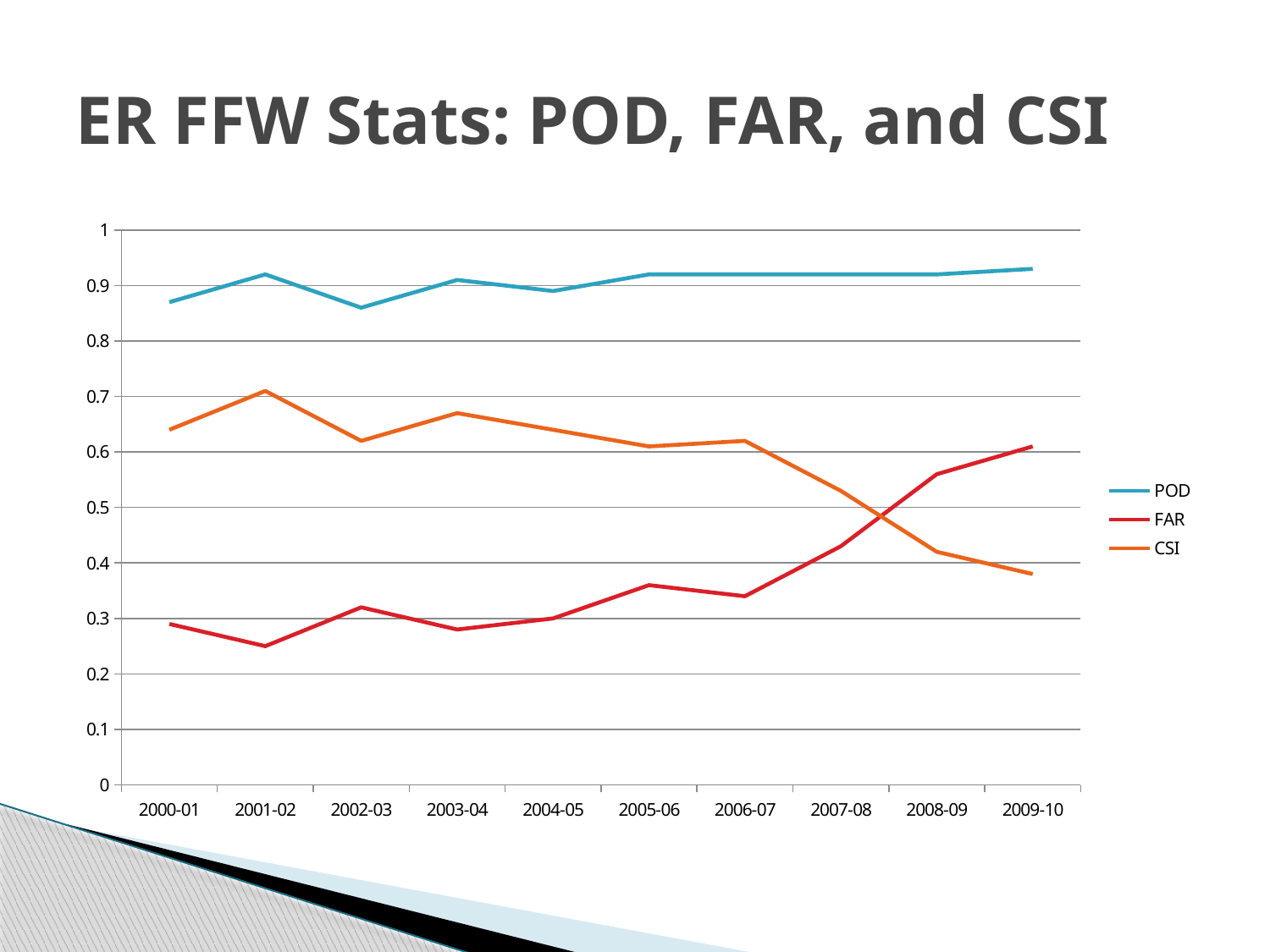
Which is larger in 2009-10, FAR or CSI? FAR In which season is CSI at its lowest? 2009-10 Is the value for FAR in 2008-09 greater or less than 0.5? greater In which season is FAR at its highest? 2009-10 How many seasons are shown along the x axis? 10 How many series does the legend list? 3 Is the value for FAR in 2001-02 greater or less than 0.3? less What kind of chart is shown on the slide? line chart Which series has the highest values across all seasons? POD Does FAR generally rise or fall from 2000-01 to 2009-10? rise What is the title of the chart slide? ER FFW Stats: POD, FAR, and CSI In which season is CSI at its highest? 2001-02